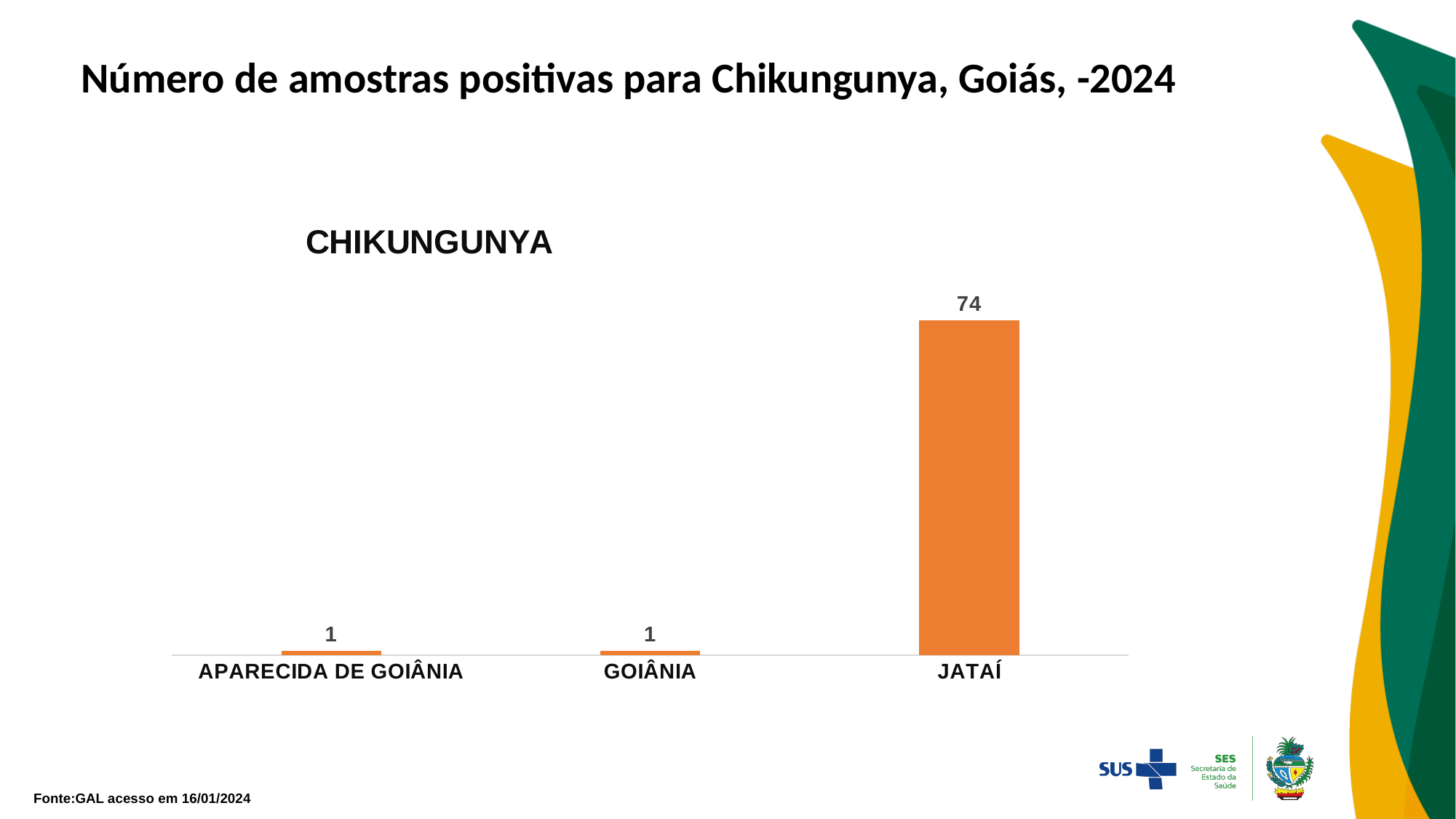
What is the difference between the values for JATAÍ and GOIÂNIA? 73 What is the value for APARECIDA DE GOIÂNIA? 1 What is the value for GOIÂNIA? 1 What is the title of the chart? CHIKUNGUNYA What colour are the bars on the chart? orange Which category has the highest value? JATAÍ What is the total of all the values shown on the chart? 76 How many categories are shown on the chart? 3 What is the value for JATAÍ? 74 What kind of chart is shown on the slide? bar chart Which is larger, the value for JATAÍ or the value for APARECIDA DE GOIÂNIA? JATAÍ